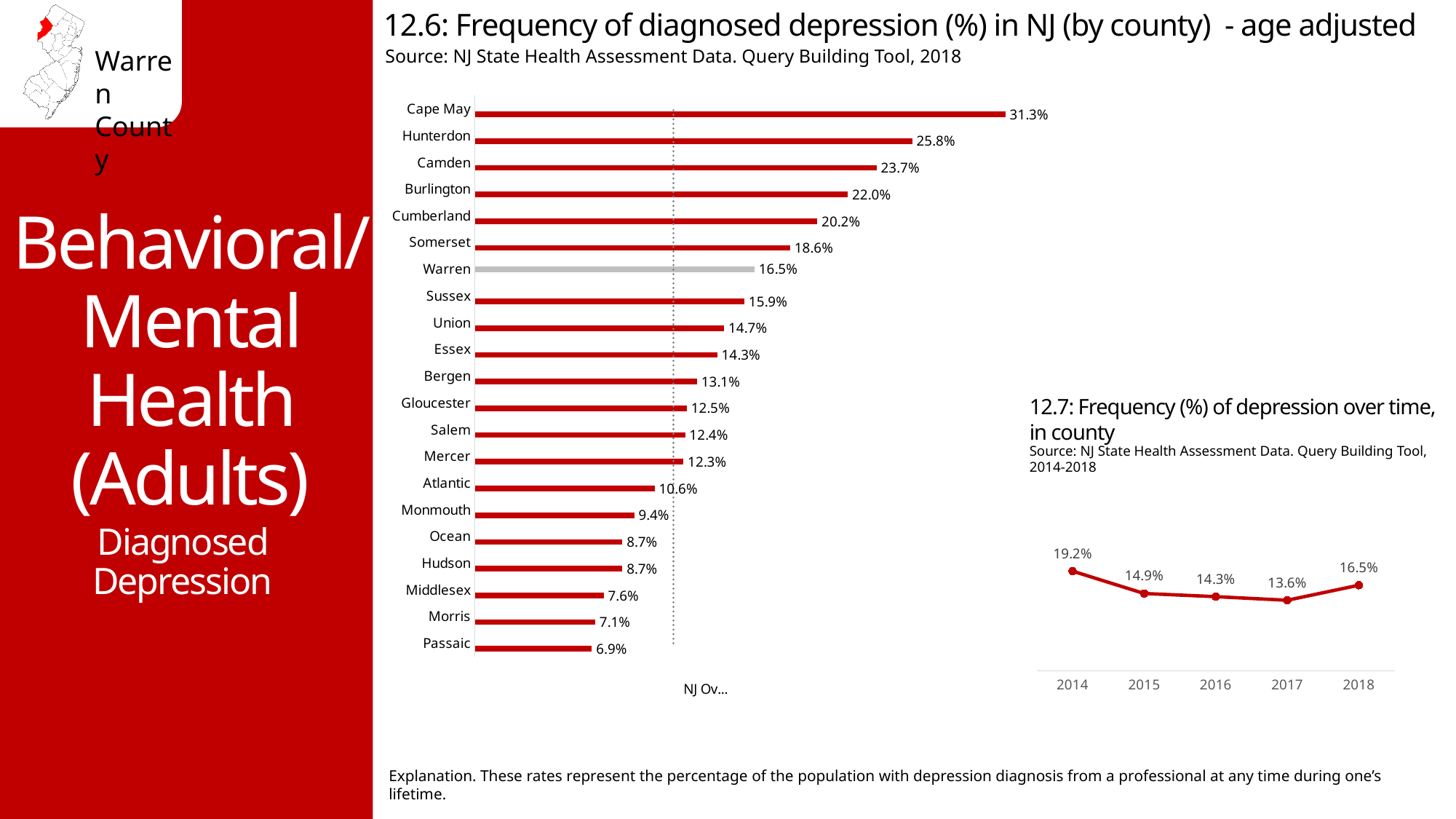
In chart 12.6 (frequency of diagnosed depression by county), which county has the highest value? Cape May In chart 12.6 (frequency of diagnosed depression by county), what is the value for Atlantic? 10.6% In chart 12.7 (frequency of depression over time), what is the value for 2017? 13.6% What kind of chart is chart 12.6 (frequency of diagnosed depression by county)? Bar chart In chart 12.6 (frequency of diagnosed depression by county), which is larger, the value for Somerset or the value for Sussex? Somerset In chart 12.6 (frequency of diagnosed depression by county), what is the difference between Cape May and Hunterdon? 5.5% In chart 12.7 (frequency of depression over time), which year has the highest value? 2014 In chart 12.6 (frequency of diagnosed depression by county), which county has the lowest value? Passaic In chart 12.7 (frequency of depression over time), what is the difference between 2014 and 2018? 2.7% In chart 12.6 (frequency of diagnosed depression by county), how many counties are shown? 21 In chart 12.6 (frequency of diagnosed depression by county), what is the value for Warren? 16.5% What kind of chart is chart 12.7 (frequency of depression over time)? Line chart